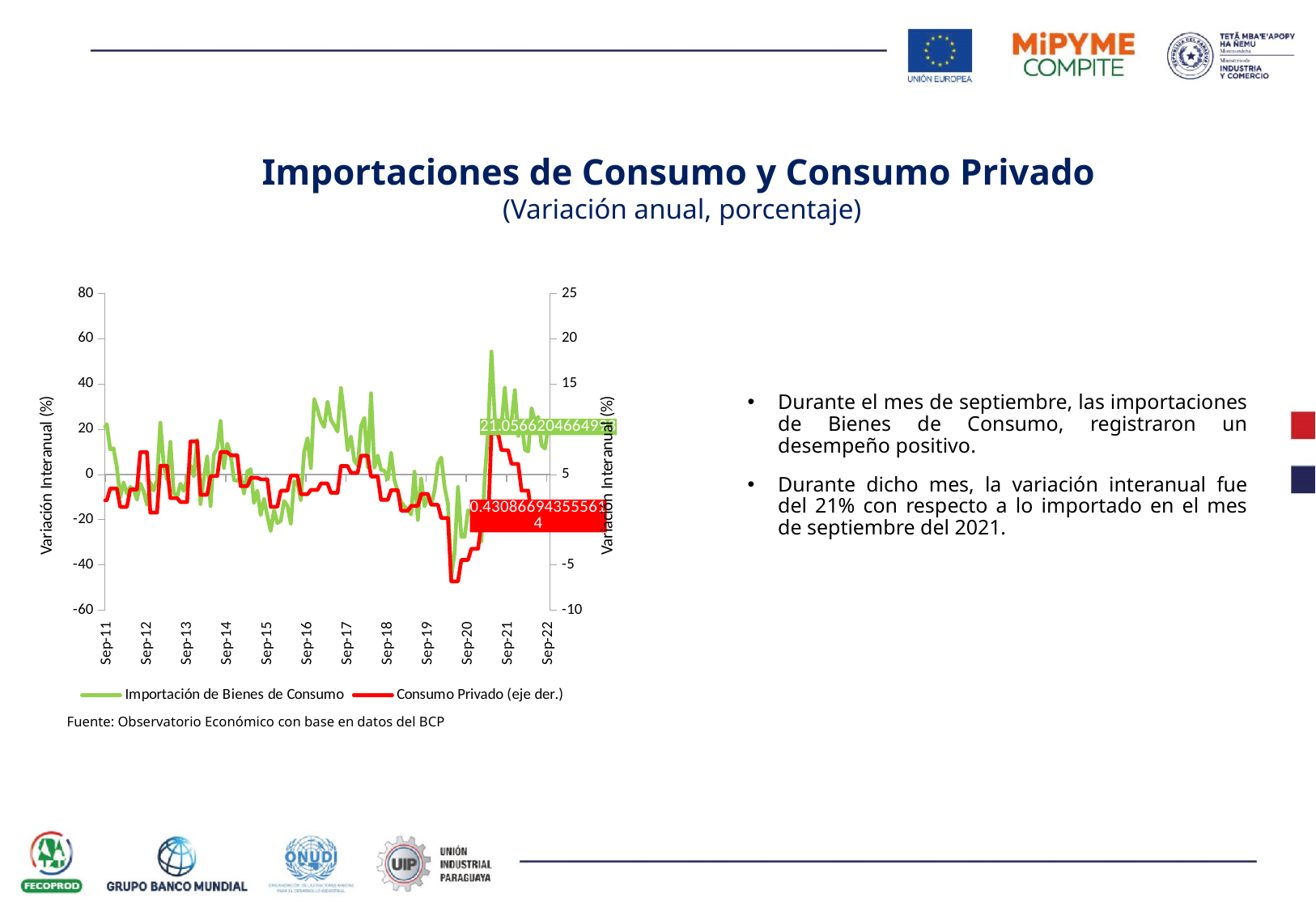
What is the highest tick value shown on the left y axis of the chart? 80 Is the value for Importación de Bienes de Consumo at Sep-22 greater or less than 40? less Which series is plotted on the right-hand axis? Consumo Privado (eje der.) How many series does the chart legend list? 2 How many tick labels are shown on the x axis of the chart? 12 Is the lowest value of the Consumo Privado (eje der.) series, reached around Sep-20, greater or less than -5 on the right axis? less What are the two series named in the chart legend? Importación de Bienes de Consumo; Consumo Privado (eje der.) Is the peak value of the Importación de Bienes de Consumo series (around Sep-20 to Sep-21) greater or less than 40 on the left axis? greater What kind of chart is shown on the slide? line chart What is the data label shown for the Consumo Privado (eje der.) series at the end of the chart? 0.430866943555614 What is the title of the chart on the slide? Importaciones de Consumo y Consumo Privado (Variación anual, porcentaje)